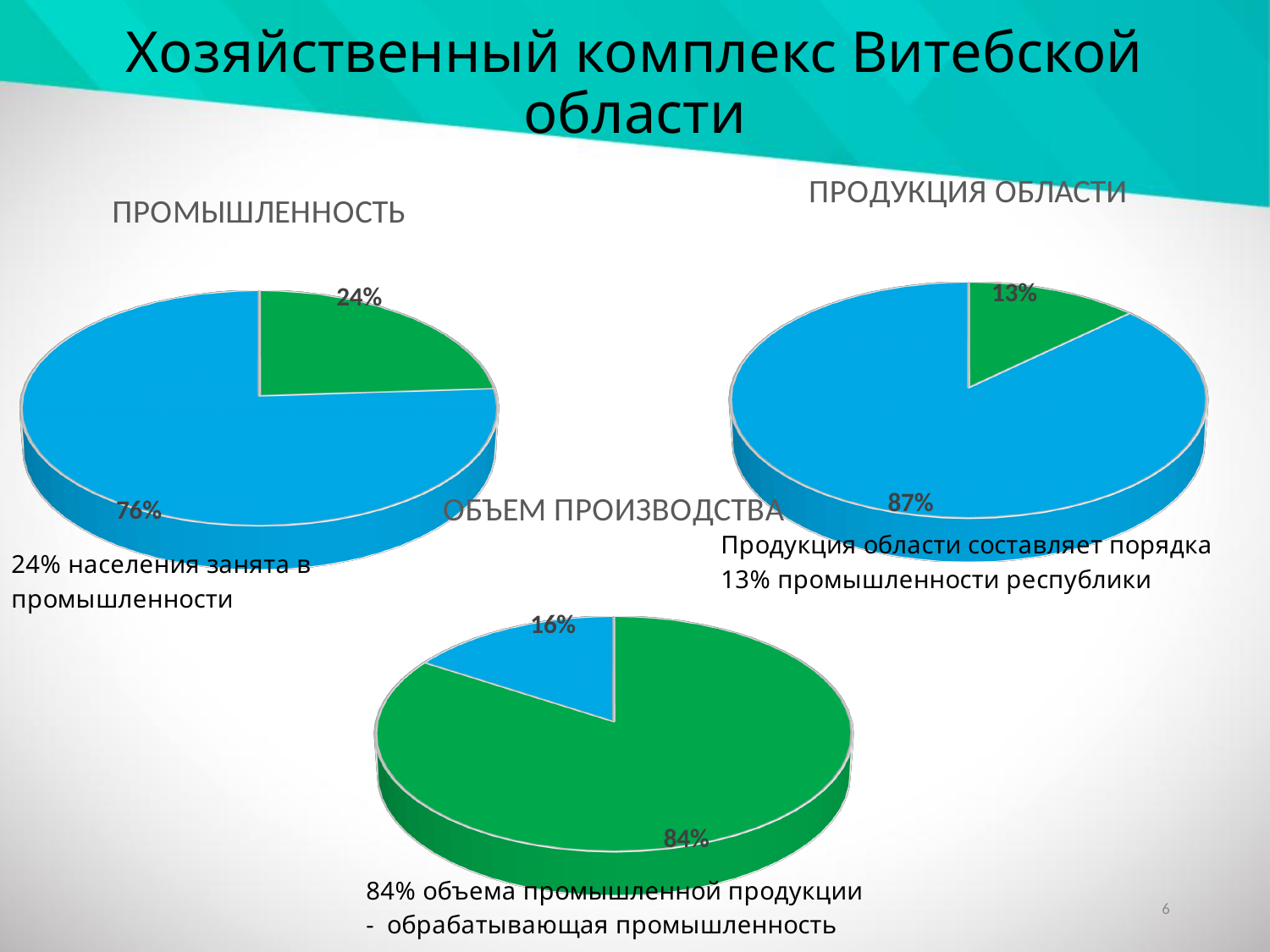
In the "ОБЪЕМ ПРОИЗВОДСТВА" chart, what percentage is shown on the blue slice? 16% What kind of chart is the "ПРОМЫШЛЕННОСТЬ" chart? pie chart In the "ПРОМЫШЛЕННОСТЬ" chart, what percentage is shown on the blue slice? 76% In the "ПРОМЫШЛЕННОСТЬ" chart, what percentage is shown on the green slice? 24% In the "ПРОМЫШЛЕННОСТЬ" chart, how many slices does the pie have? 2 How many pie charts are shown on the slide? 3 In the "ПРОМЫШЛЕННОСТЬ" chart, what is the difference between the blue slice and the green slice? 52% In the "ОБЪЕМ ПРОИЗВОДСТВА" chart, what percentage is shown on the green slice? 84% In the "ПРОДУКЦИЯ ОБЛАСТИ" chart, what percentage is shown on the green slice? 13% In the "ПРОДУКЦИЯ ОБЛАСТИ" chart, what percentage is shown on the blue slice? 87% In the "ОБЪЕМ ПРОИЗВОДСТВА" chart, which slice is larger, the green one or the blue one? green In the "ПРОДУКЦИЯ ОБЛАСТИ" chart, what is the difference between the blue slice and the green slice? 74%